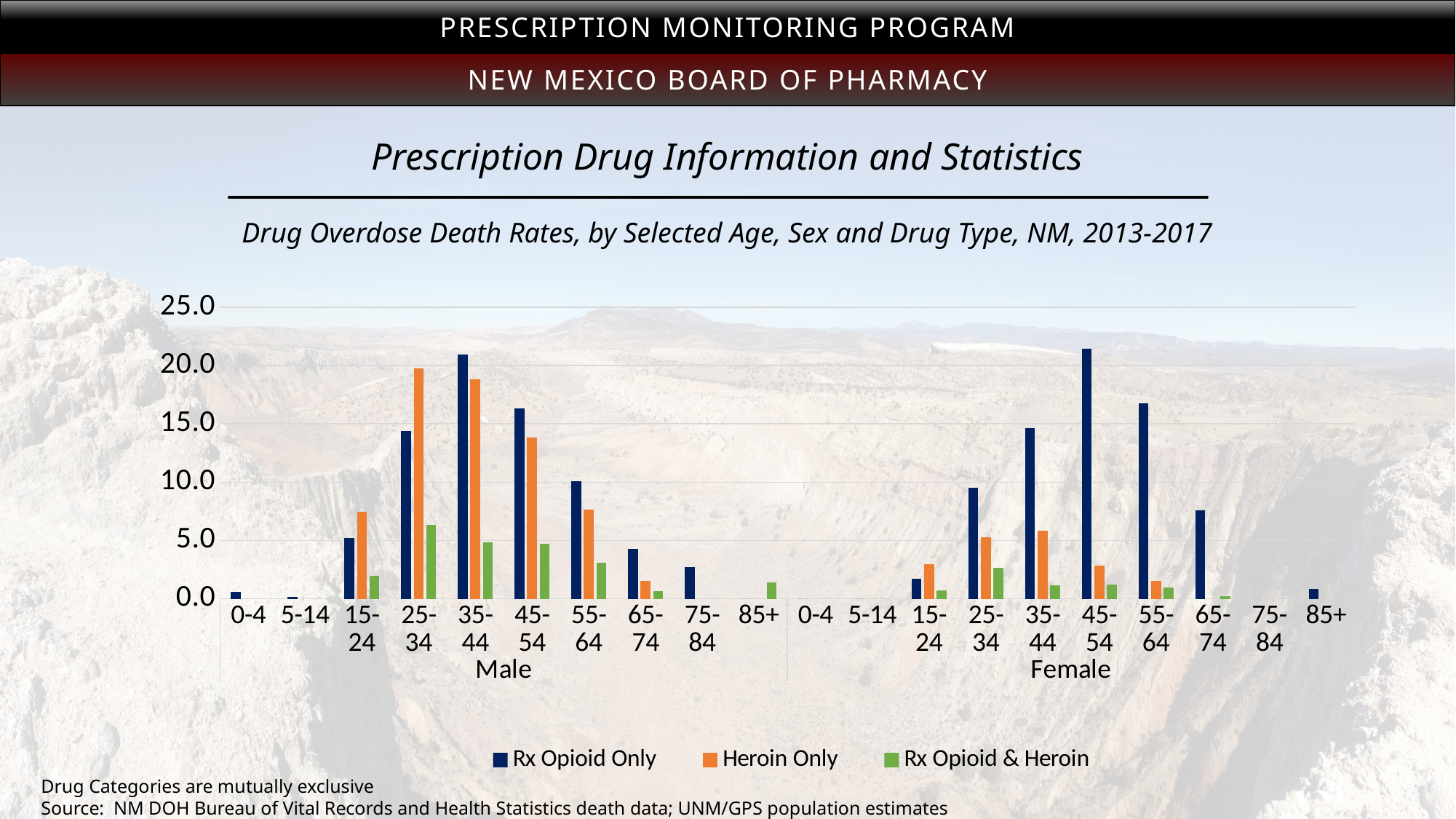
For females aged 35-44, which is larger: Rx Opioid Only or Heroin Only? Rx Opioid Only What are the three series named in the legend? Rx Opioid Only, Heroin Only, Rx Opioid & Heroin How many series does the legend list? 3 Is the Rx Opioid Only value for females aged 45-54 greater or less than 20.0? greater How many age groups are shown on the x axis for each sex? 10 Among males, which age group has the highest Rx Opioid Only death rate? 35-44 For males aged 25-34, which is larger: Rx Opioid Only or Heroin Only? Heroin Only What is the title of the chart? Drug Overdose Death Rates, by Selected Age, Sex and Drug Type, NM, 2013-2017 Is the Rx Opioid Only value for males aged 35-44 greater or less than 15.0? greater Is the Rx Opioid Only value for females aged 25-34 greater or less than 10.0? less What kind of chart is shown on the slide? bar chart Among females, which age group has the highest Rx Opioid Only death rate? 45-54